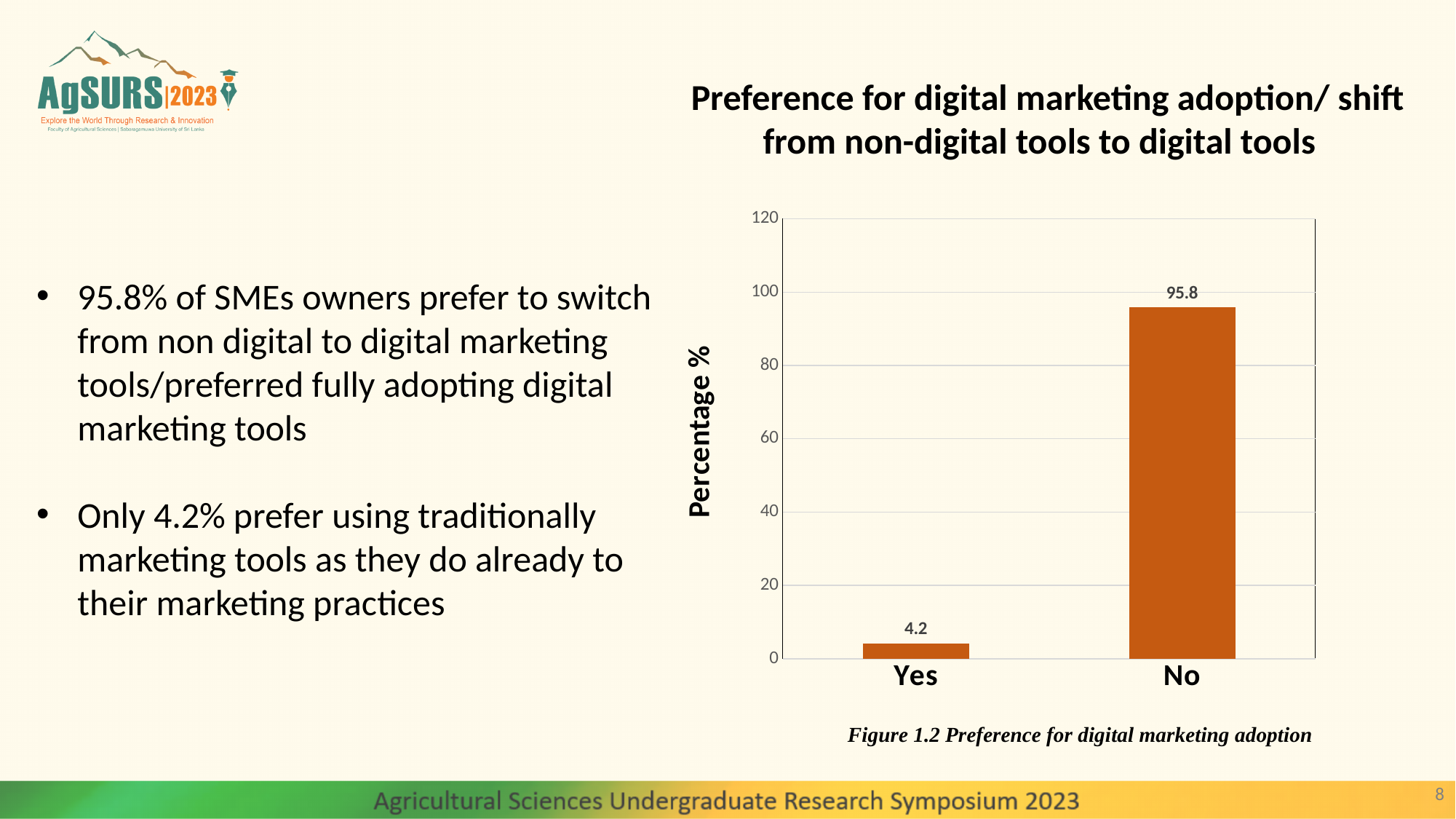
What is the figure caption below the chart? Figure 1.2 Preference for digital marketing adoption What is the value for the "No" category? 95.8 What is the label of the vertical axis? Percentage % Which category has the highest value? No How many categories are shown on the x axis? 2 Is the value for "Yes" greater or less than 20? less What is the difference between the values for "No" and "Yes"? 91.6 Which is larger, the value for "Yes" or the value for "No"? No What is the value for the "Yes" category? 4.2 What kind of chart is shown on the slide? Bar chart Is the value for "No" greater or less than 80? greater Which category has the lowest value? Yes